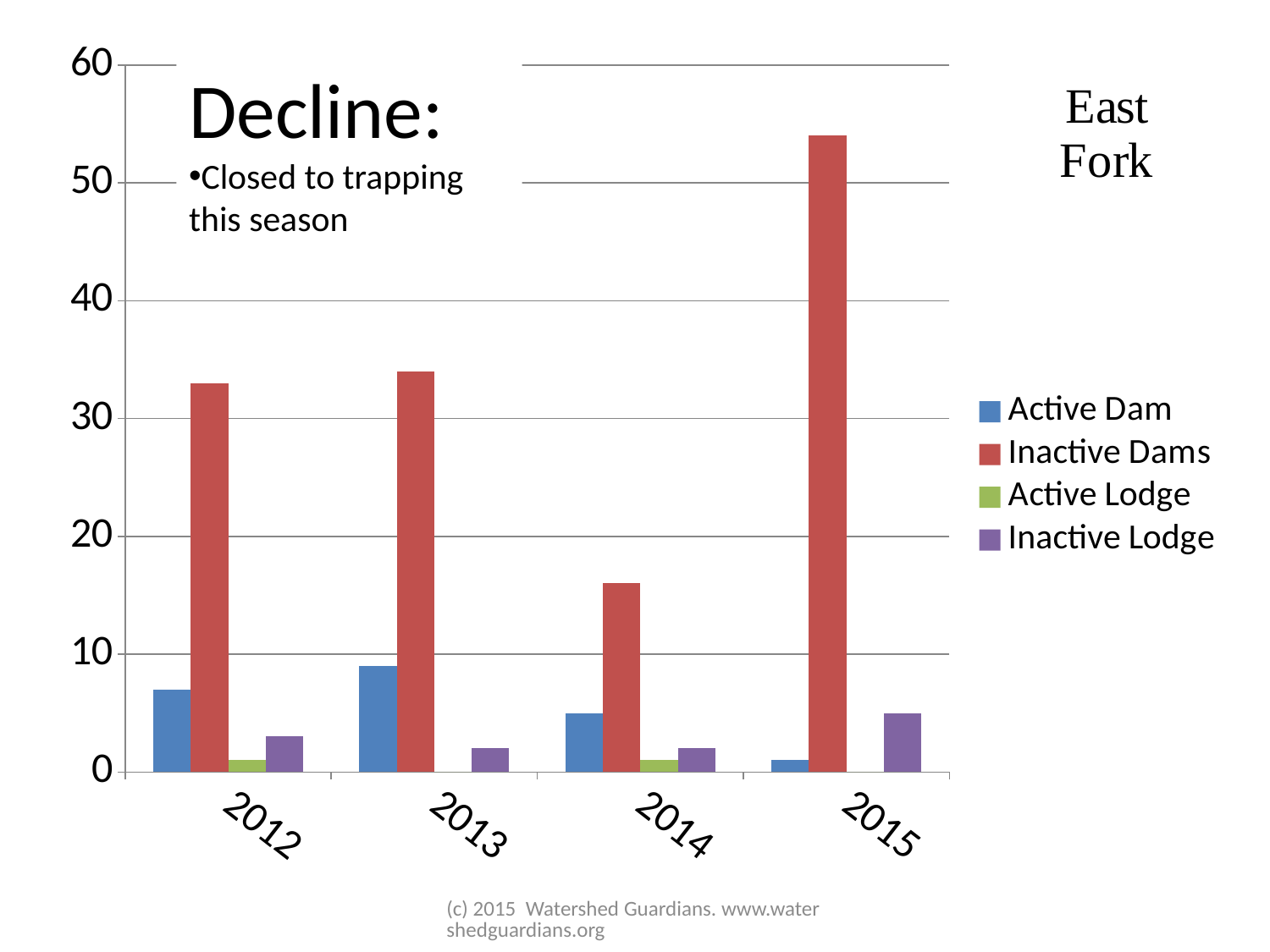
How many years are shown on the x axis? 4 In which year is the Inactive Dams value lowest? 2014 In which year is the Active Dam value highest? 2013 How many series does the legend list? 4 Which is larger, the Inactive Dams value for 2012 or for 2014? 2012 In which year is the Active Dam value lowest? 2015 Does the Active Dam value rise or fall from 2013 to 2015? fall Is the Active Dam value for 2013 greater or less than 10? less Is the Inactive Dams value for 2015 greater or less than 50? greater In which year is the Inactive Dams value highest? 2015 Is the Inactive Dams value for 2014 greater or less than 20? less What kind of chart is shown on the slide? bar chart